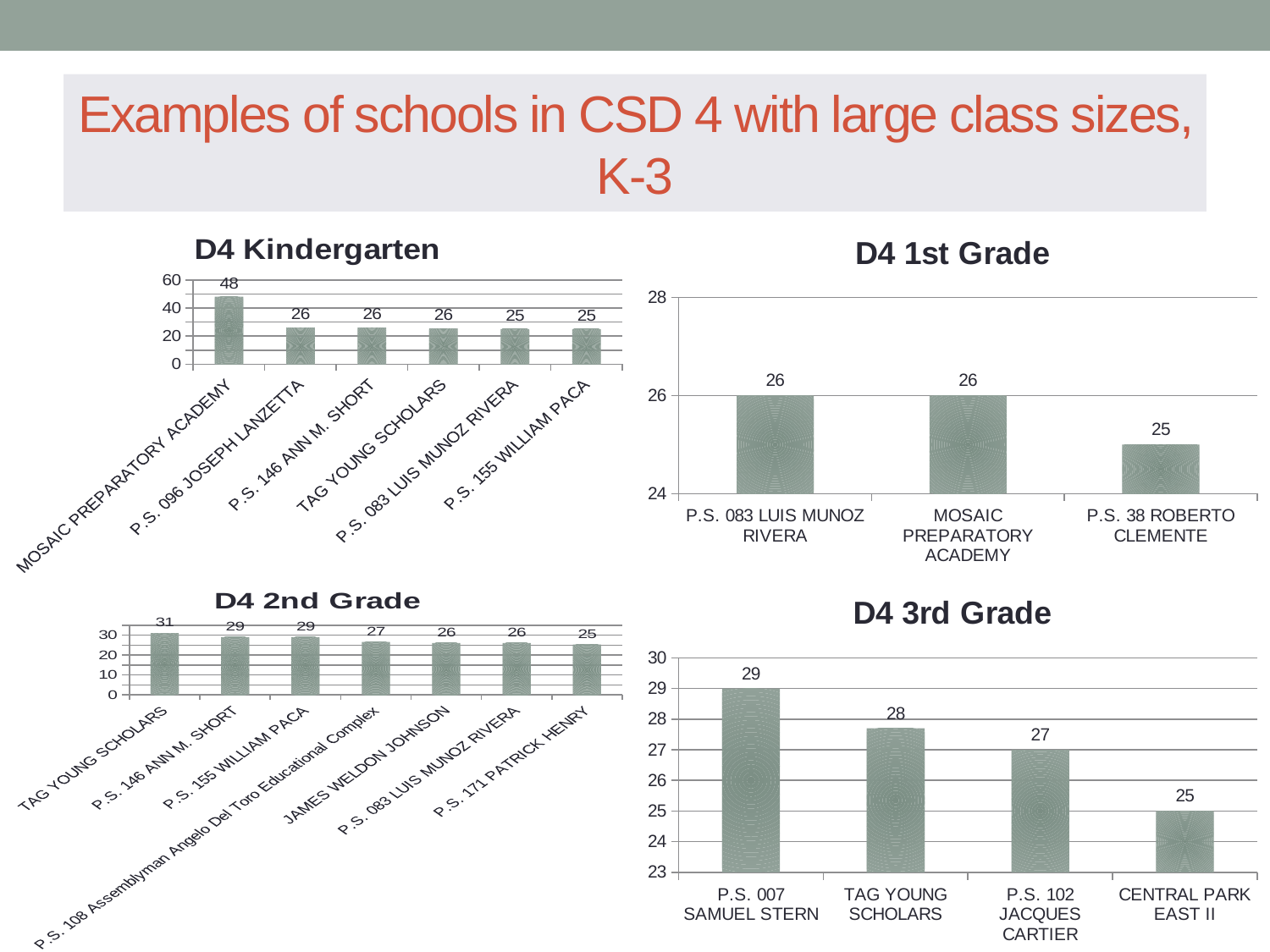
In the D4 1st Grade chart, which school has the lowest value? P.S. 38 ROBERTO CLEMENTE How many schools are shown in the D4 Kindergarten chart? 6 How many schools are shown in the D4 1st Grade chart? 3 In the D4 2nd Grade chart, what is the value for TAG YOUNG SCHOLARS? 31 In the D4 Kindergarten chart, what is the value for MOSAIC PREPARATORY ACADEMY? 48 How many schools are shown in the D4 2nd Grade chart? 7 In the D4 Kindergarten chart, which school has the highest value? MOSAIC PREPARATORY ACADEMY In the D4 3rd Grade chart, what is the difference between P.S. 007 SAMUEL STERN and CENTRAL PARK EAST II? 4 In the D4 Kindergarten chart, what is the difference between MOSAIC PREPARATORY ACADEMY and P.S. 155 WILLIAM PACA? 23 In the D4 2nd Grade chart, which school has the lowest value? P.S. 171 PATRICK HENRY What type of chart is the D4 3rd Grade chart? Bar chart In the D4 1st Grade chart, what is the value for P.S. 38 ROBERTO CLEMENTE? 25